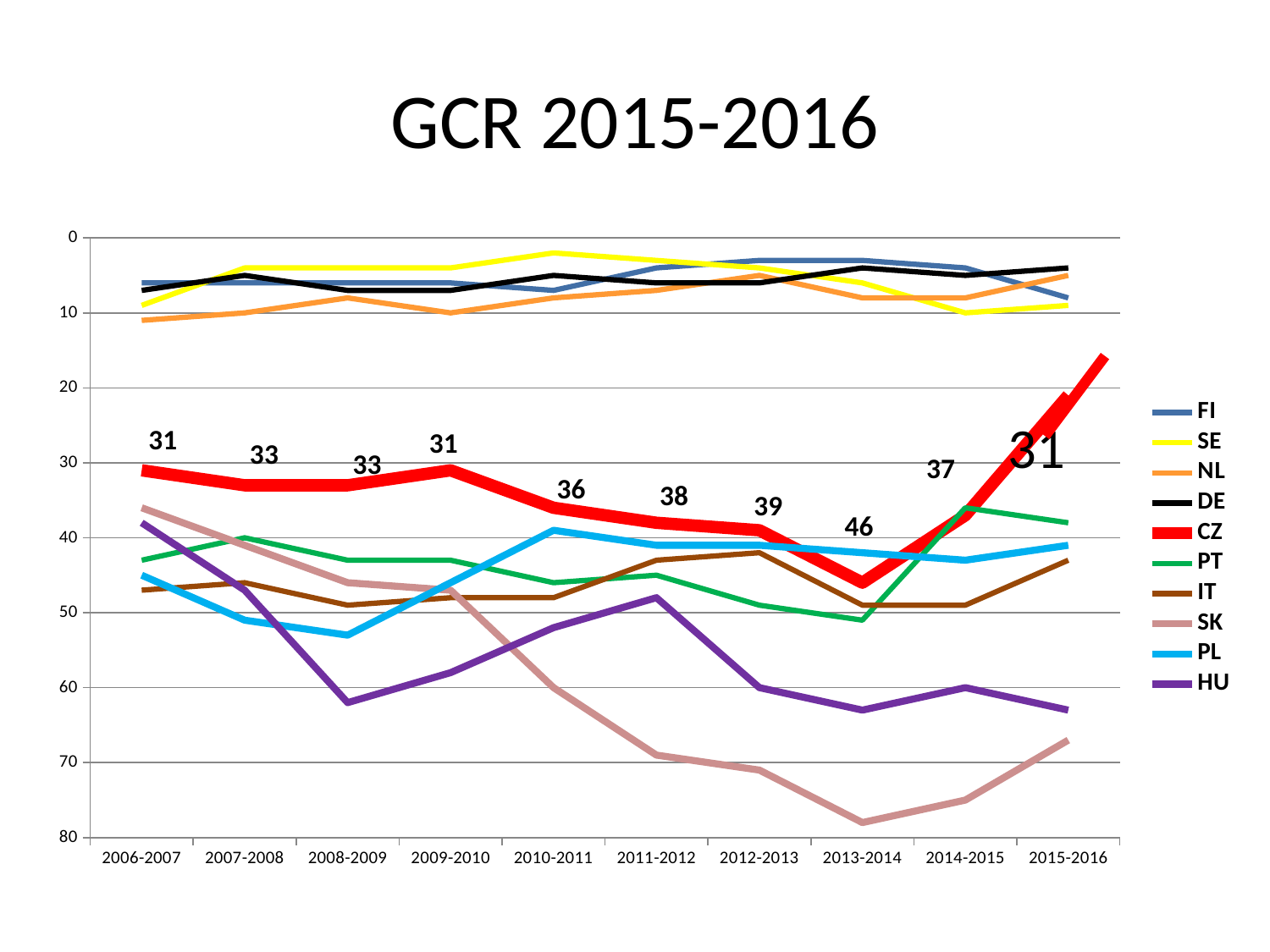
What is the labelled value for CZ in 2010-2011? 36 Do the CZ labelled values rise or fall from 2009-2010 to 2013-2014? rise Is the value for SK in 2013-2014 greater or less than 70? greater In which season does the CZ series have its largest labelled value? 2013-2014 How many series does the legend list? 10 What is the title of the chart? GCR 2015-2016 How many seasons are shown along the x axis? 10 What is the labelled value for CZ in 2013-2014? 46 What kind of chart is shown on the slide? line chart Which CZ labelled value is larger, 2013-2014 or 2014-2015? 2013-2014 What is the labelled value for CZ in 2014-2015? 37 What is the difference between the CZ labelled values for 2013-2014 and 2012-2013? 7